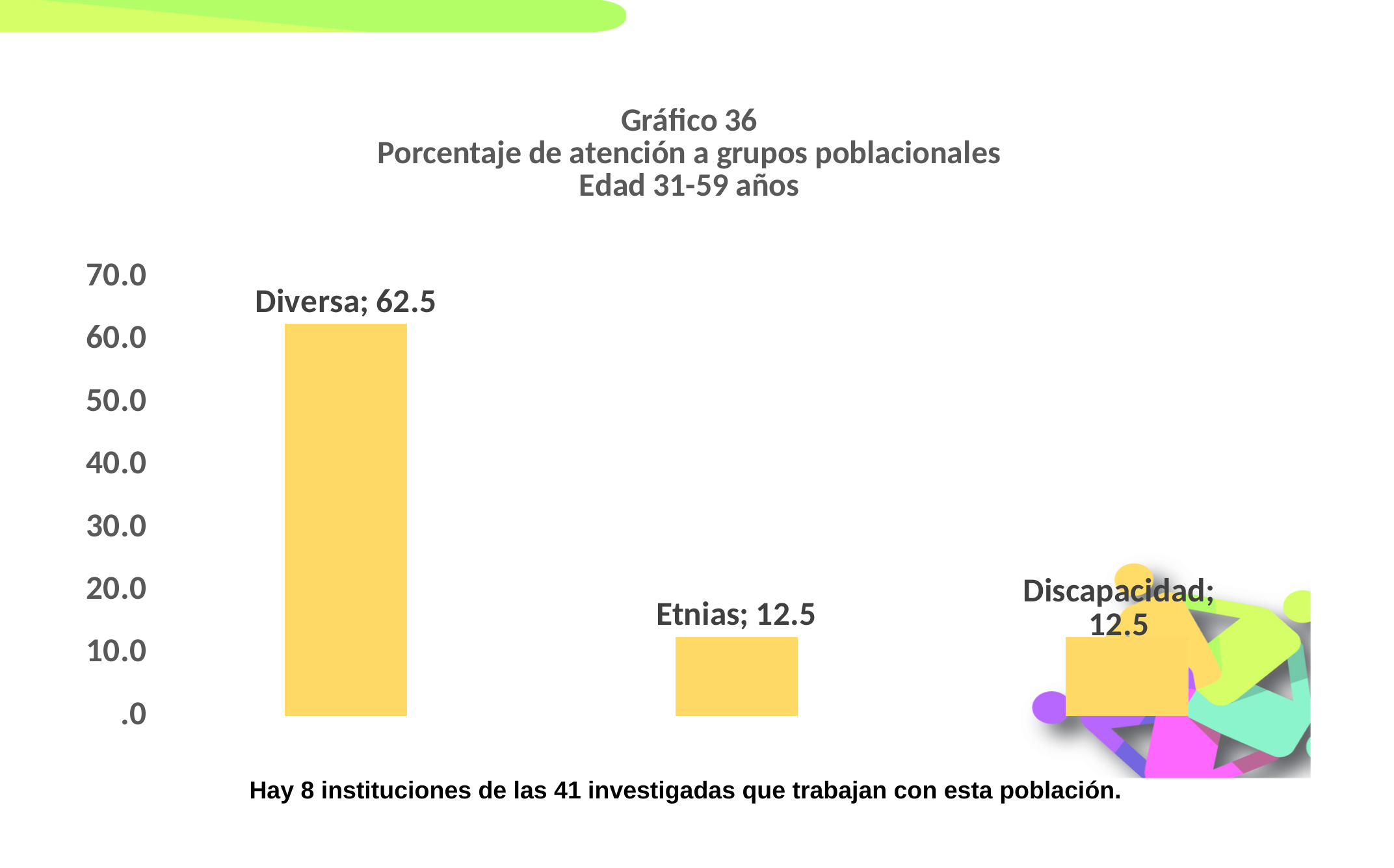
Is the value for Etnias greater or less than 20.0? less What is the difference between the values for Diversa and Etnias? 50.0 Which is larger, the value for Diversa or the value for Discapacidad? Diversa Which category has the highest value? Diversa How many categories are shown in the chart? 3 What is the value for Discapacidad? 12.5 What is the number of the chart according to its title? Gráfico 36 What is the value for Diversa? 62.5 What is the age range given in the chart title? 31-59 años Is the value for Diversa greater or less than 50.0? greater What kind of chart is shown on the slide? bar chart What is the value for Etnias? 12.5